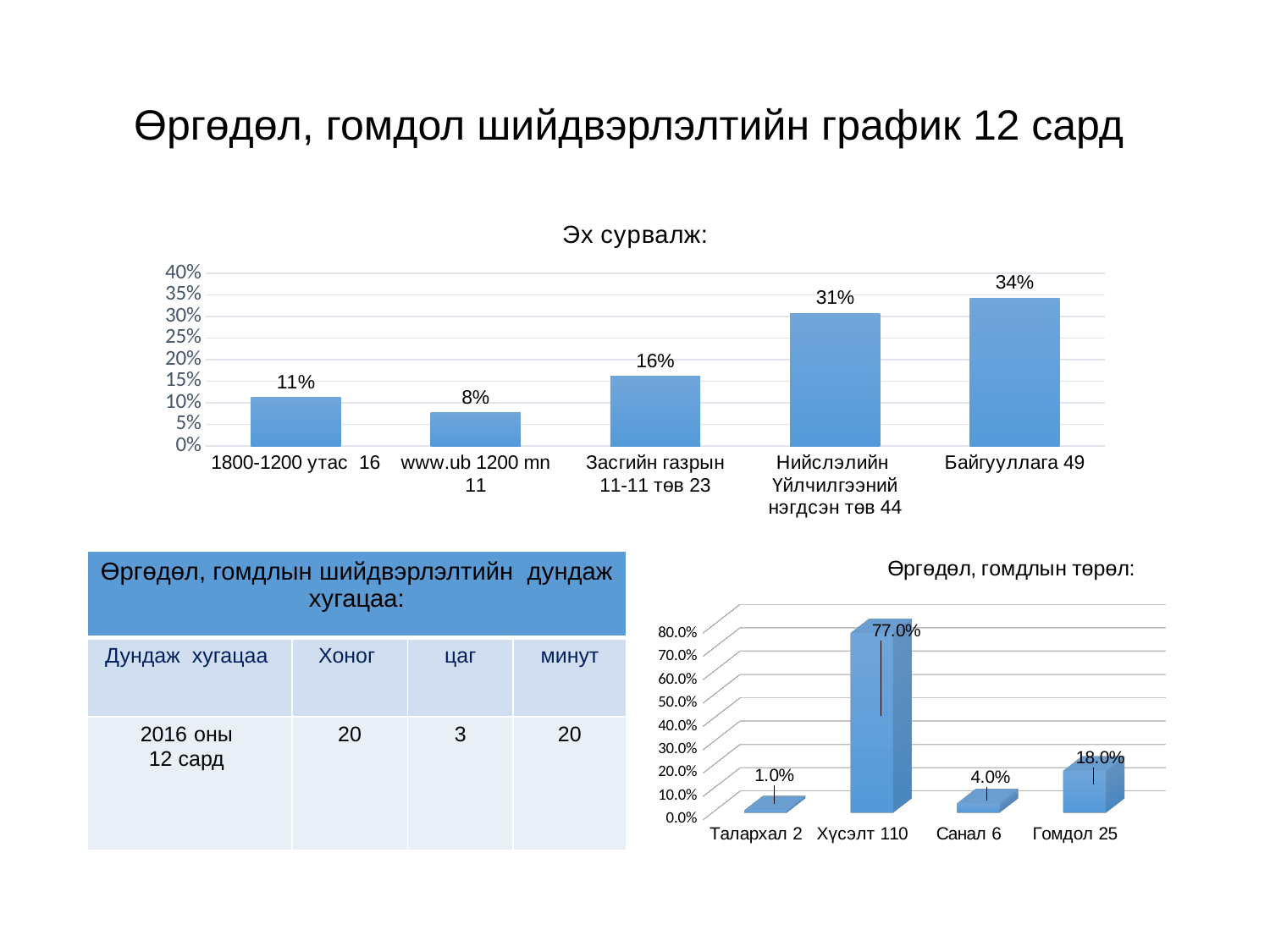
In the 'Эх сурвалж:' chart, which category has the lowest value? www.ub 1200 mn 11 In the 'Өргөдөл, гомдлын төрөл:' chart, what is the value for 'Гомдол 25'? 18.0% In the 'Өргөдөл, гомдлын төрөл:' chart, which is larger, 'Санал 6' or 'Гомдол 25'? Гомдол 25 In the 'Эх сурвалж:' chart, what is the value for 'Байгууллага 49'? 34% In the 'Эх сурвалж:' chart, what is the value for 'www.ub 1200 mn 11'? 8% In the 'Өргөдөл, гомдлын төрөл:' chart, what is the value for 'Хүсэлт 110'? 77.0% What kind of chart is the 'Өргөдөл, гомдлын төрөл:' chart? bar chart In the 'Эх сурвалж:' chart, what is the difference between 'Нийслэлийн Үйлчилгээний нэгдсэн төв 44' and 'Засгийн газрын 11-11 төв 23'? 15% In the 'Эх сурвалж:' chart, is the value for '1800-1200 утас 16' greater or less than 15%? less In the 'Өргөдөл, гомдлын төрөл:' chart, which category has the lowest value? Талархал 2 In the 'Эх сурвалж:' chart, which category has the highest value? Байгууллага 49 In the 'Эх сурвалж:' chart, how many categories are shown? 5